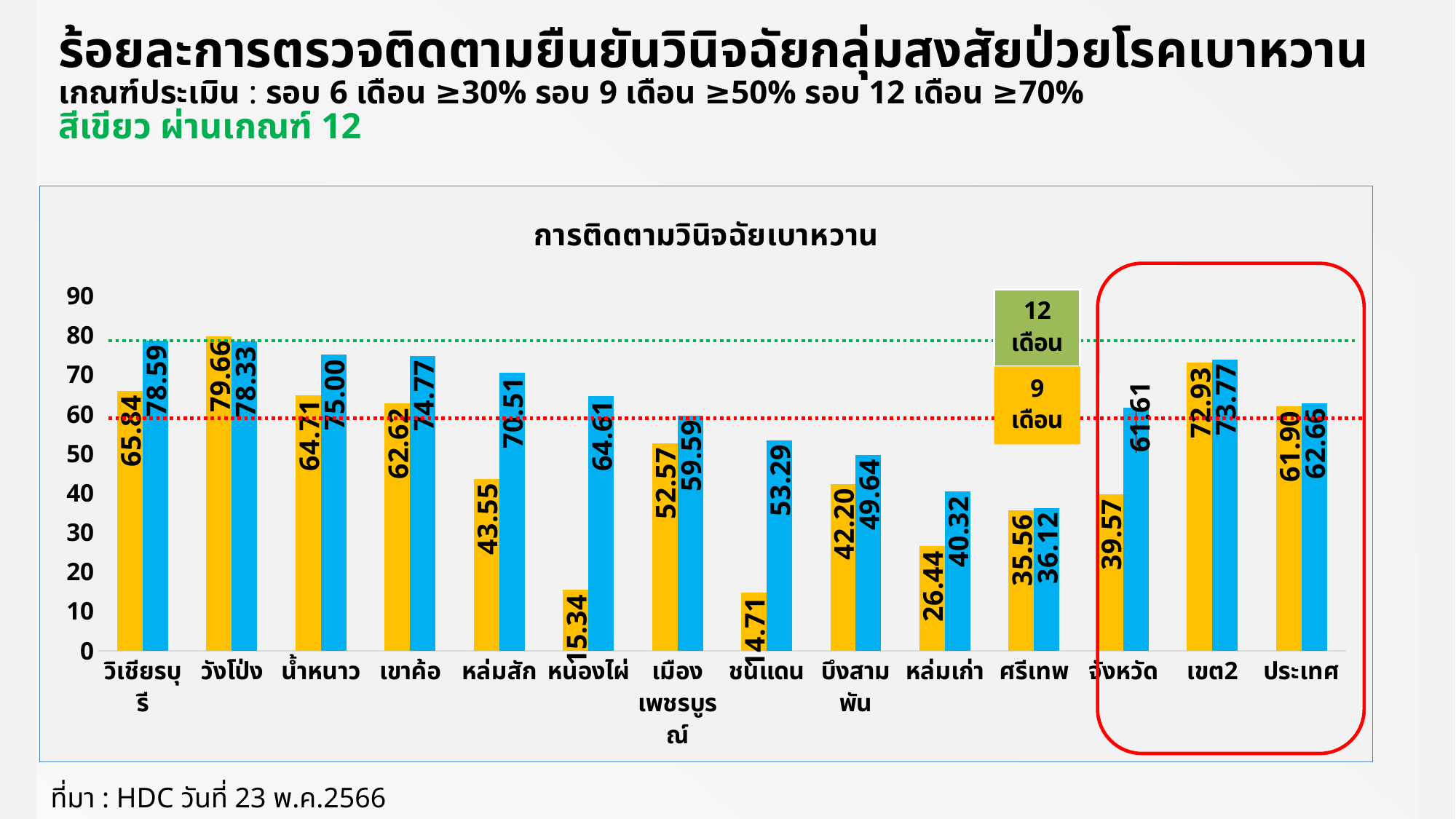
How many categories are shown on the x axis? 14 What is the 12 เดือน value for หล่มสัก? 70.51 How many series does the legend list? 2 Which category has the lowest 9 เดือน value? ชนแดน Which category has the highest 9 เดือน value? วังโป่ง Is the 12 เดือน value for ชนแดน greater or less than 50? greater What is the 12 เดือน value for จังหวัด? 61.61 What is the difference between the 12 เดือน and 9 เดือน values for หนองไผ่? 49.27 Which is larger for วังโป่ง, the 9 เดือน value or the 12 เดือน value? 9 เดือน What type of chart is shown? bar chart Which category has the lowest 12 เดือน value? ศรีเทพ What is the 9 เดือน value for หนองไผ่? 15.34